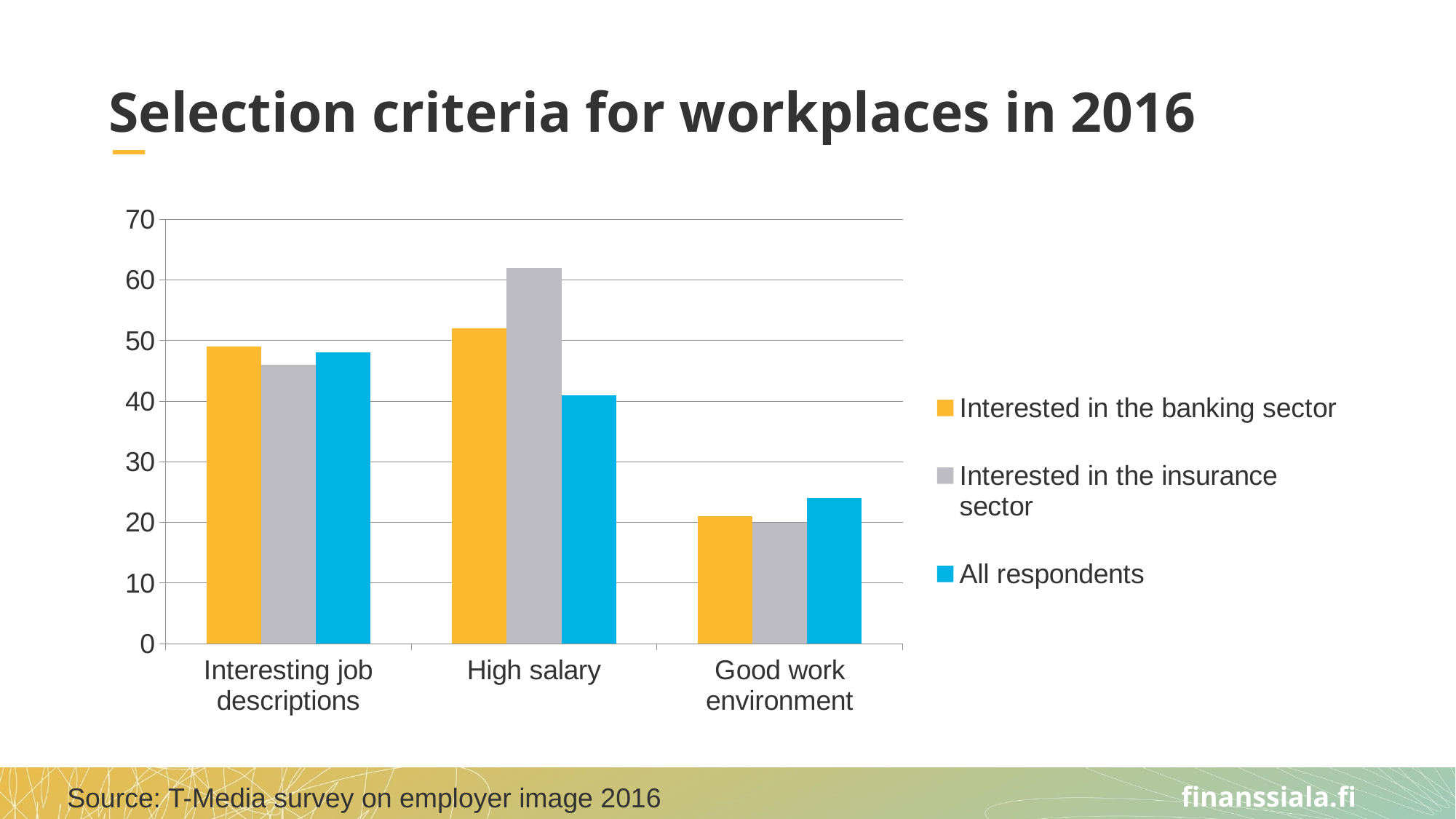
For 'High salary', which is larger: 'Interested in the insurance sector' or 'Interested in the banking sector'? Interested in the insurance sector How many categories are shown on the x axis? 3 Which category has the lowest value for the 'Interested in the banking sector' series? Good work environment What kind of chart is shown on the slide? bar chart How many series does the legend list? 3 Which category has the lowest value for the 'All respondents' series? Good work environment Which category has the highest value for the 'Interested in the insurance sector' series? High salary What is the title of the chart on the slide? Selection criteria for workplaces in 2016 Is the value for 'Interested in the banking sector' in 'Good work environment' greater or less than 30? less Is the value for 'Interested in the insurance sector' in 'High salary' greater or less than 50? greater Is the value for 'All respondents' in 'High salary' greater or less than 50? less For 'High salary', which is larger: 'Interested in the banking sector' or 'All respondents'? Interested in the banking sector